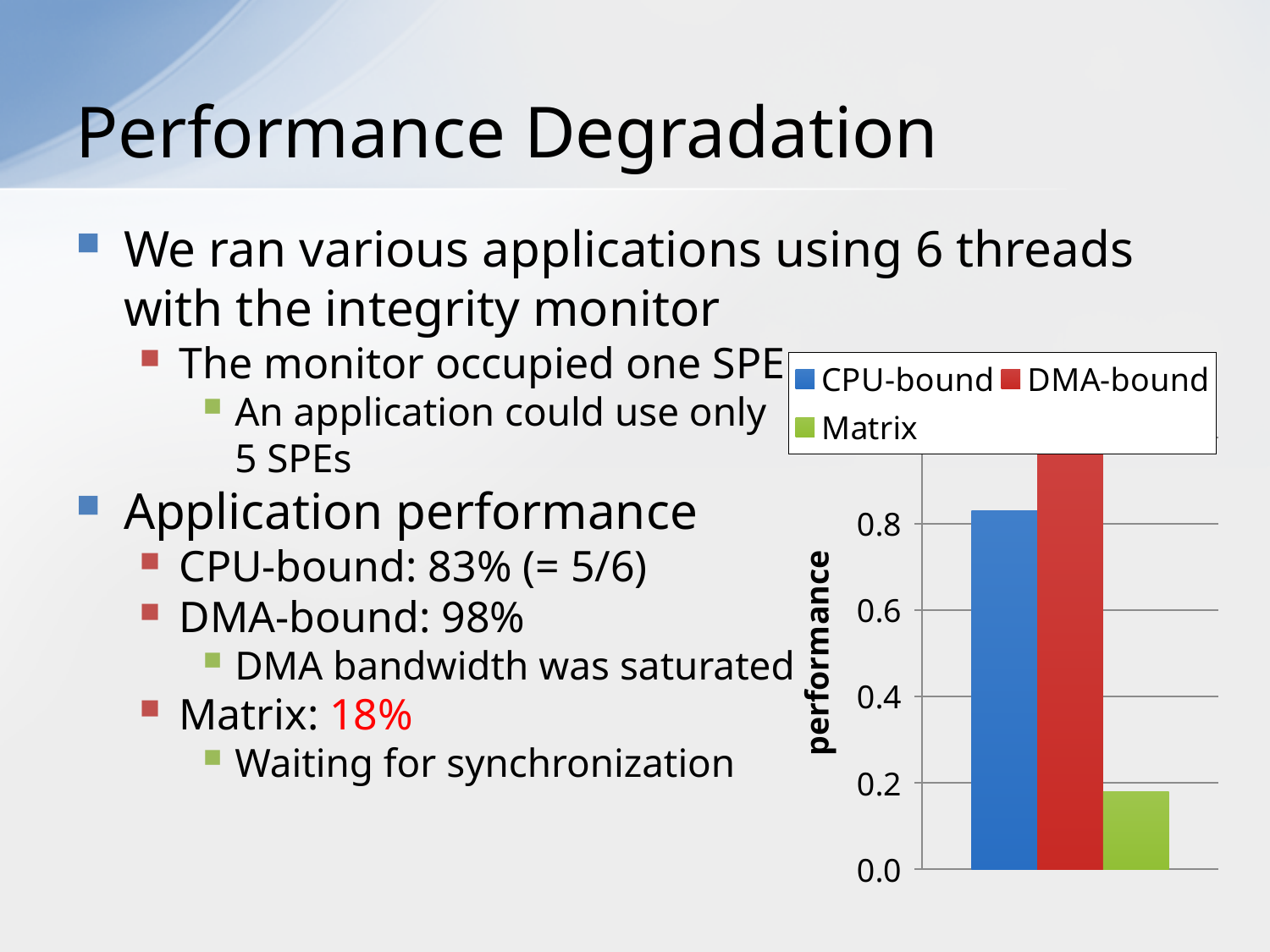
What is the label on the chart's vertical axis? performance Is the bar for Matrix greater or less than 0.2? less What colour is the Matrix bar in the chart? green Which series has the highest bar in the chart? DMA-bound Which is larger in the chart, the DMA-bound bar or the CPU-bound bar? DMA-bound How many series does the chart's legend list? 3 Is the bar for DMA-bound greater or less than 0.8? greater What kind of chart is shown on the slide? bar chart Is the bar for CPU-bound greater or less than 0.8? greater Which is larger in the chart, the CPU-bound bar or the Matrix bar? CPU-bound Which series has the lowest bar in the chart? Matrix How many bars are plotted in the chart? 3